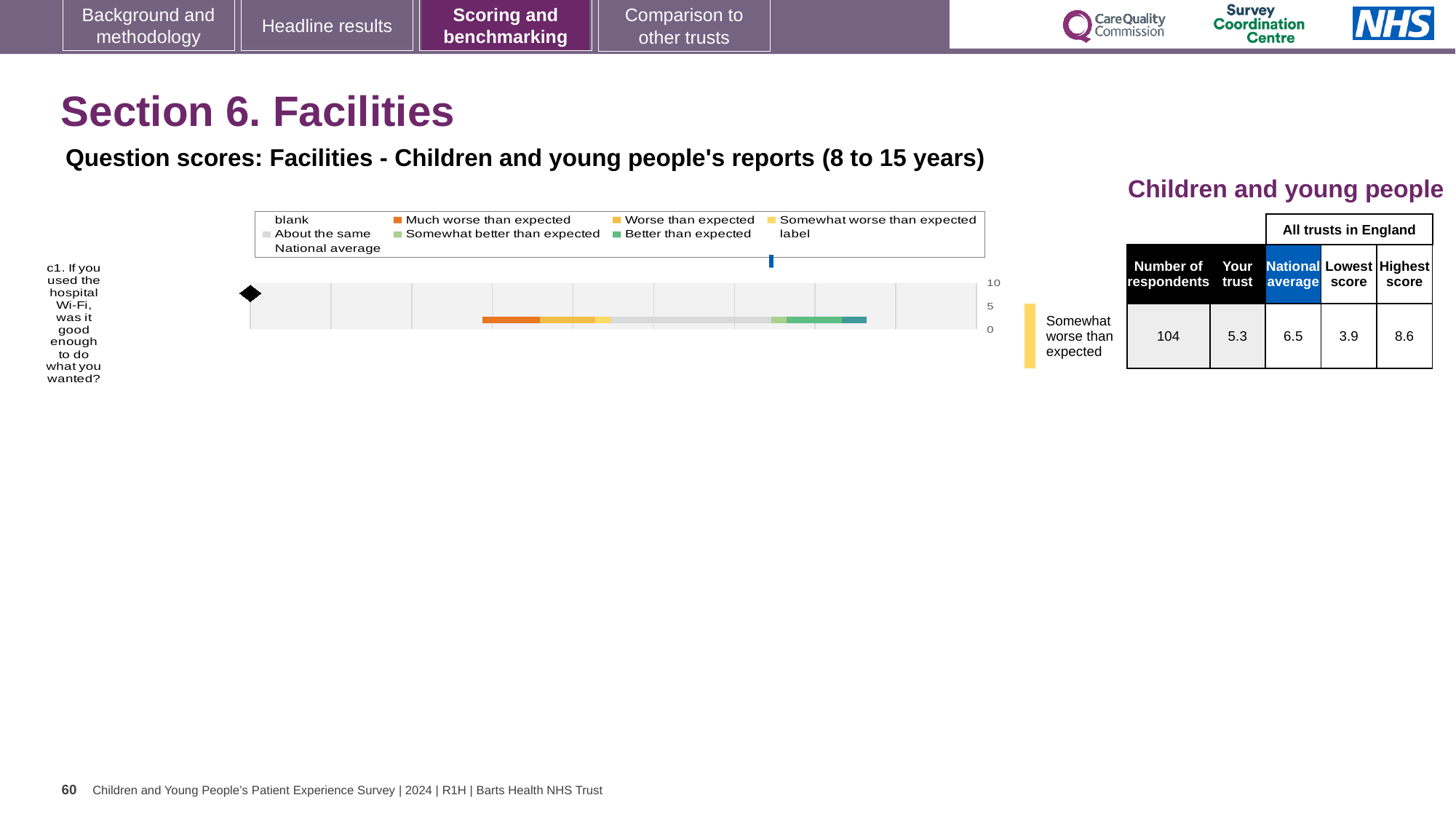
What colour represents 'Much worse than expected' in the chart legend? Orange By how much is the national average higher than the trust's score for question c1? 1.2 Which is larger for question c1: the trust's score or the national average? National average What is the national average score for question c1? 6.5 How many survey questions are plotted in the chart? 1 How many respondents answered question c1? 104 What is the difference between the highest score and the lowest score for question c1? 4.7 What kind of chart is used to show the question score for c1? bar chart What is the lowest score among all trusts in England for question c1? 3.9 What is the 'Your trust' score for question c1 about the hospital Wi-Fi? 5.3 Which benchmark category is the trust's result for question c1 placed in? Somewhat worse than expected What is the highest score among all trusts in England for question c1? 8.6